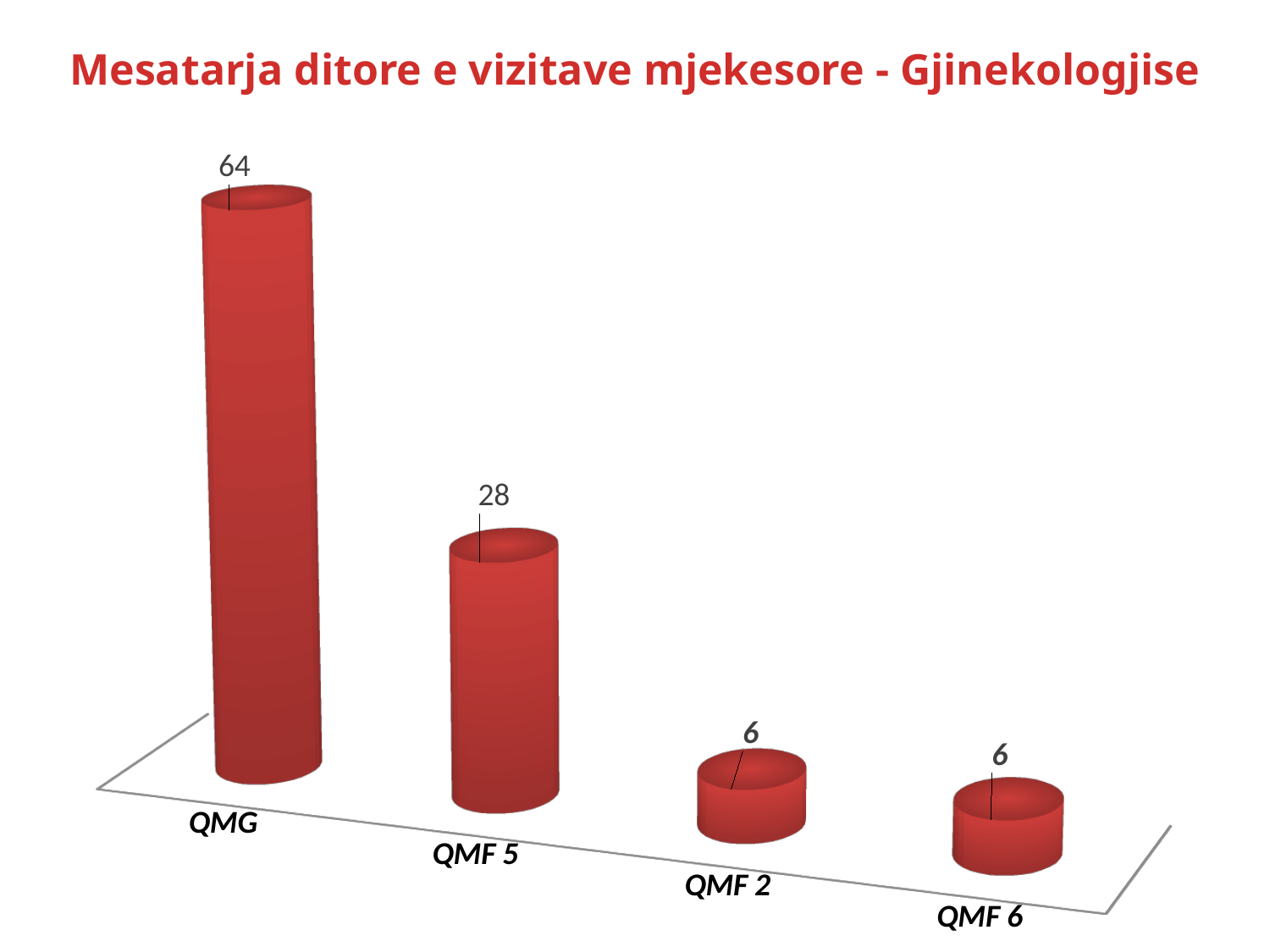
What is the value for QMF 5? 28 Which category has the highest value? QMG What is the title of the chart? Mesatarja ditore e vizitave mjekesore - Gjinekologjise What is the difference between the values for QMF 5 and QMF 2? 22 How many categories are shown in the chart? 4 What is the difference between the values for QMG and QMF 5? 36 What is the value for QMF 6? 6 What kind of chart is shown on the slide? bar chart What is the value for QMG? 64 Do the values rise or fall from QMG to QMF 2 along the x axis? fall What is the value for QMF 2? 6 Which is larger, the value for QMF 5 or the value for QMF 6? QMF 5